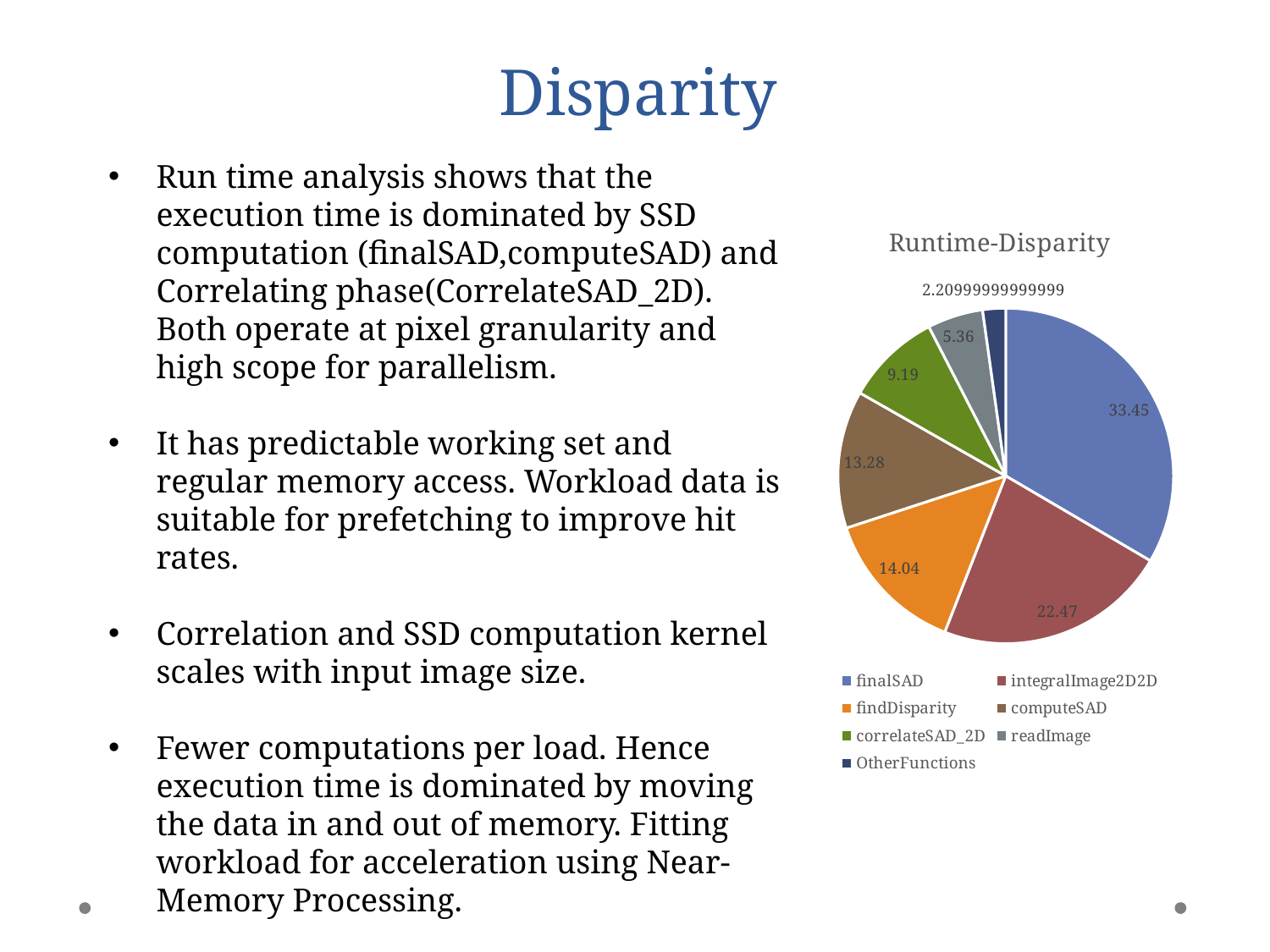
Which category has the largest slice in the Runtime-Disparity chart? finalSAD What is the value for computeSAD in the Runtime-Disparity chart? 13.28 What is the value for finalSAD in the Runtime-Disparity chart? 33.45 How many categories does the legend of the Runtime-Disparity chart list? 7 What type of chart is shown on the slide? pie chart What is the value for readImage in the Runtime-Disparity chart? 5.36 What is the difference between the values for finalSAD and integralImage2D2D? 10.98 What is the value for findDisparity in the Runtime-Disparity chart? 14.04 Which category has the smallest slice in the Runtime-Disparity chart? OtherFunctions What is the title of the chart? Runtime-Disparity What is the value for integralImage2D2D in the Runtime-Disparity chart? 22.47 Which is larger, the value for correlateSAD_2D or the value for readImage? correlateSAD_2D